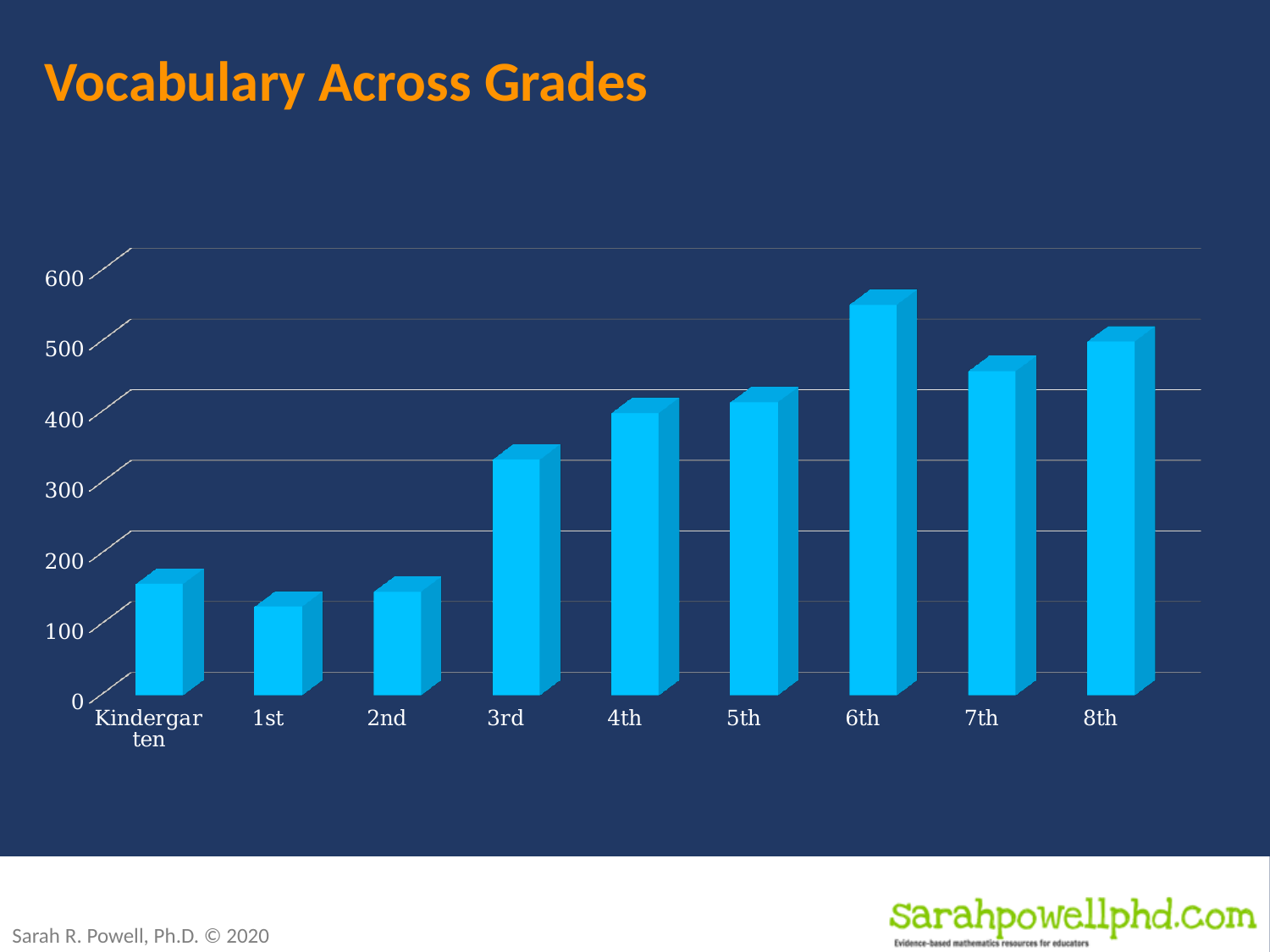
Is the value for 6th grade greater or less than 500? greater Is the value for 3rd grade greater or less than 300? greater What is the title of the chart? Vocabulary Across Grades Which grade has the lowest bar? 1st How many grade categories are plotted on the x axis? 9 Is the value for 1st grade greater or less than 200? less Do the values generally rise or fall from Kindergarten to 6th grade? rise What kind of chart is shown on the slide? bar chart Which is larger, the value for 6th grade or the value for 7th grade? 6th Which grade has the highest bar? 6th Which is larger, the value for 2nd grade or the value for 3rd grade? 3rd